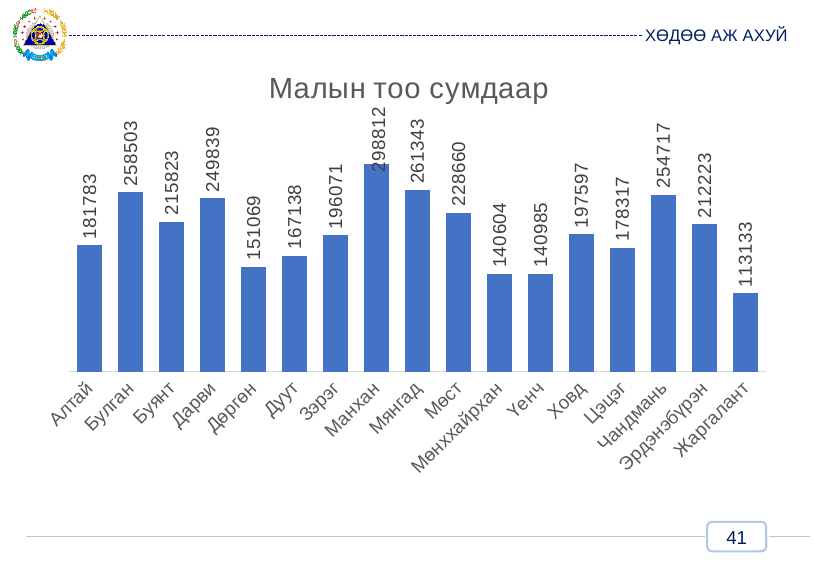
What is the value for Манхан? 298812 What is the value for Эрдэнэбүрэн? 212223 Which category has the lowest value? Жаргалант How many categories are shown on the x axis? 17 What is the title of the chart? Малын тоо сумдаар What is the difference between the values for Дарви and Дөргөн? 98770 What kind of chart is this? bar chart What is the value for Булган? 258503 What is the value for Жаргалант? 113133 What is the difference between the values for Мянгад and Мөст? 32683 Which is larger, the value for Буянт or the value for Ховд? Буянт Which category has the highest value? Манхан